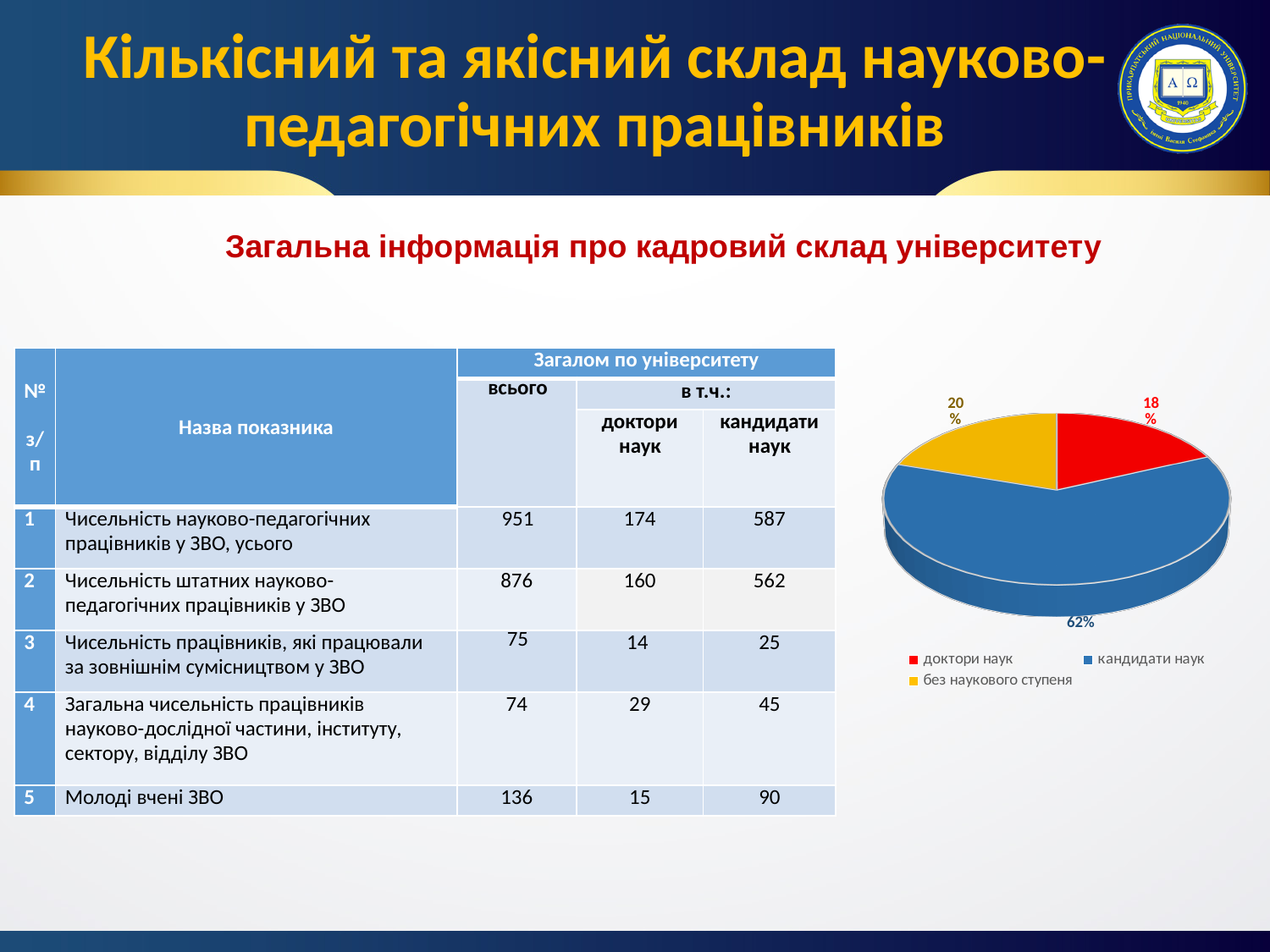
In the pie chart, which is larger: the slice for "без наукового ступеня" or the slice for "доктори наук"? без наукового ступеня What share of the pie chart is labelled for "кандидати наук"? 62% What colour is the "доктори наук" slice in the pie chart? red What is the difference in percentage points between the "кандидати наук" slice and the "доктори наук" slice in the pie chart? 44 Which category has the largest slice in the pie chart? кандидати наук Which category has the smallest slice in the pie chart? доктори наук What colour is the "кандидати наук" slice in the pie chart? blue How many entries does the pie chart legend list? 3 How many slices does the pie chart have? 3 What share of the pie chart is labelled for "доктори наук"? 18% What share of the pie chart is labelled for "без наукового ступеня"? 20% What kind of chart is shown on the slide? pie chart